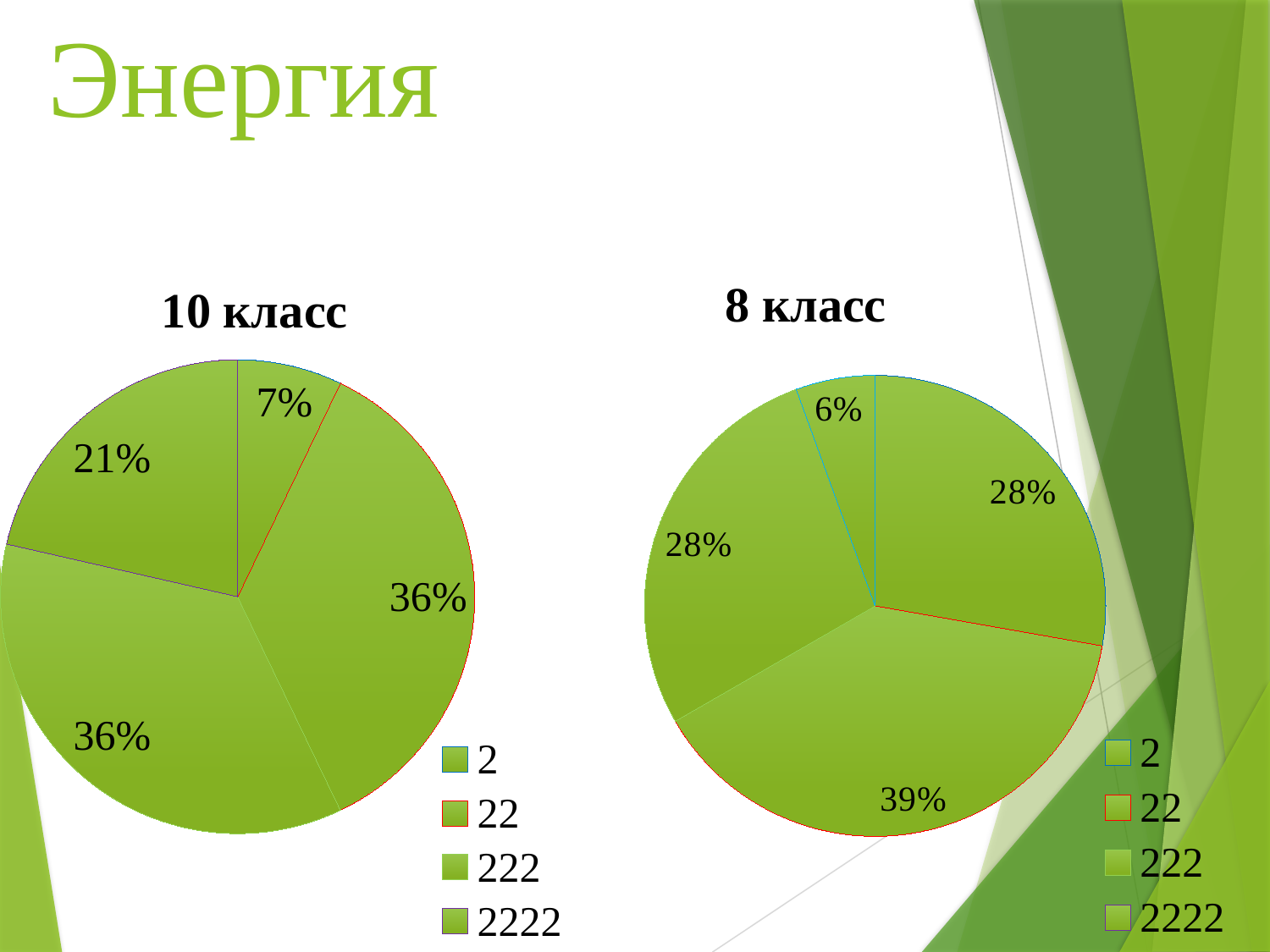
Which chart has the larger smallest slice, "10 класс" or "8 класс"? 10 класс What kind of chart is used for the "10 класс" chart? Pie chart How many slices does the "10 класс" pie chart have? 4 In the "10 класс" pie chart, what is the percentage of the smallest slice? 7% In the "10 класс" pie chart, what is the difference in percentage points between the largest slice (36%) and the smallest slice (7%)? 29 percentage points How many entries does the legend of the "8 класс" pie chart list? 4 In the "8 класс" pie chart, how many slices are labelled 28%? 2 How many pie charts are shown on the slide? 2 In the "8 класс" pie chart, what is the percentage of the smallest slice? 6% In the "8 класс" pie chart, what is the percentage of the largest slice? 39% What are the legend entries listed for the "10 класс" pie chart? 2, 22, 222, 2222 In the "8 класс" pie chart, what is the difference in percentage points between the largest slice and the smallest slice? 33 percentage points